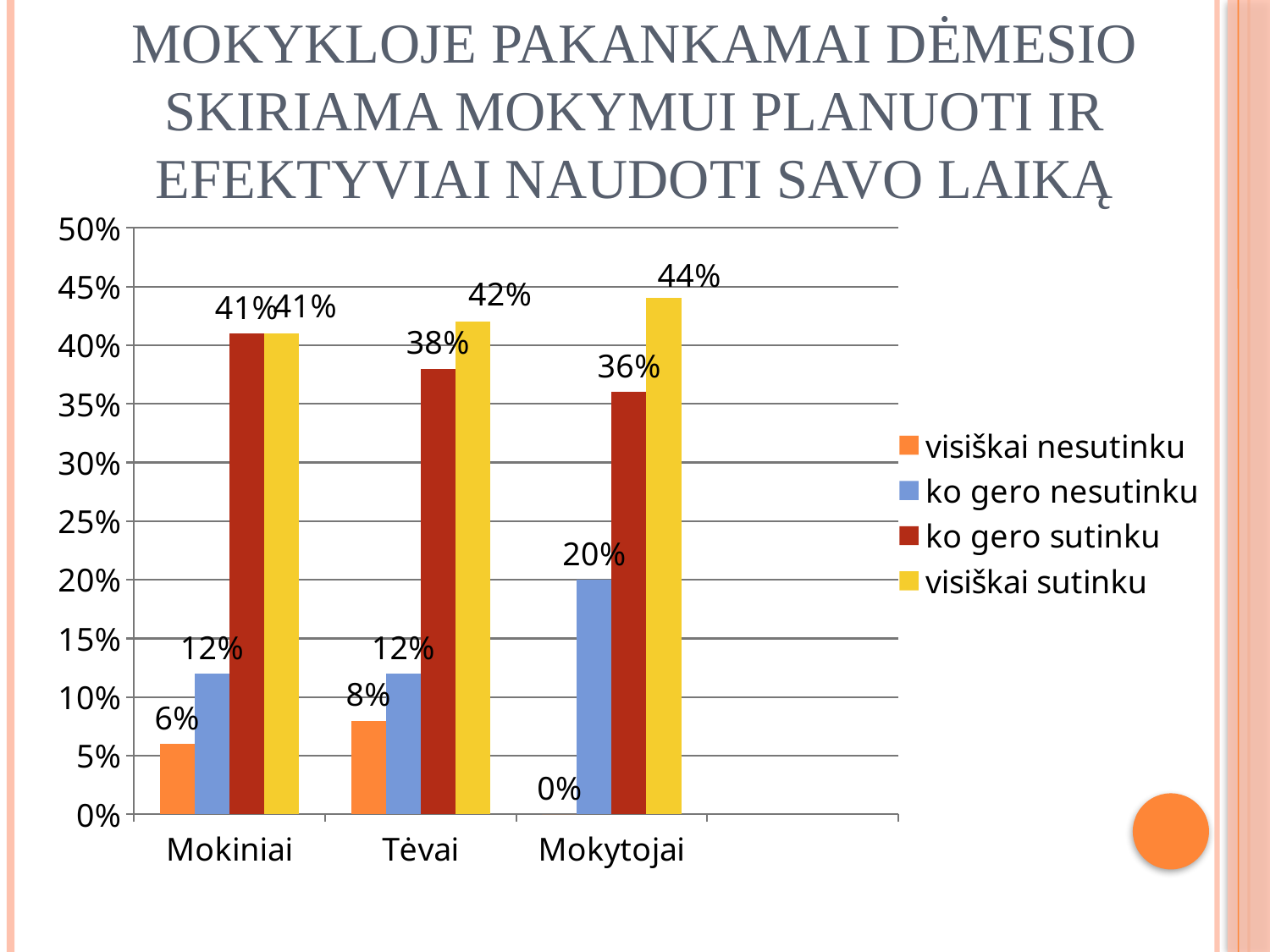
What is the value for 'ko gero sutinku' for Tėvai? 38% Which category has the lowest value for 'visiškai nesutinku'? Mokytojai What is the difference between 'visiškai sutinku' and 'ko gero sutinku' for Mokytojai? 8% Which is larger for Tėvai: 'visiškai sutinku' or 'ko gero sutinku'? visiškai sutinku How many series does the legend list? 4 What colour represents 'ko gero nesutinku' in the legend? blue What is the value for 'visiškai nesutinku' for Mokiniai? 6% What is the value for 'ko gero nesutinku' for Mokytojai? 20% How many categories are shown on the x axis? 3 Which category has the highest value for 'visiškai sutinku'? Mokytojai What is the value for 'visiškai sutinku' for Mokytojai? 44% What kind of chart is shown on the slide? bar chart